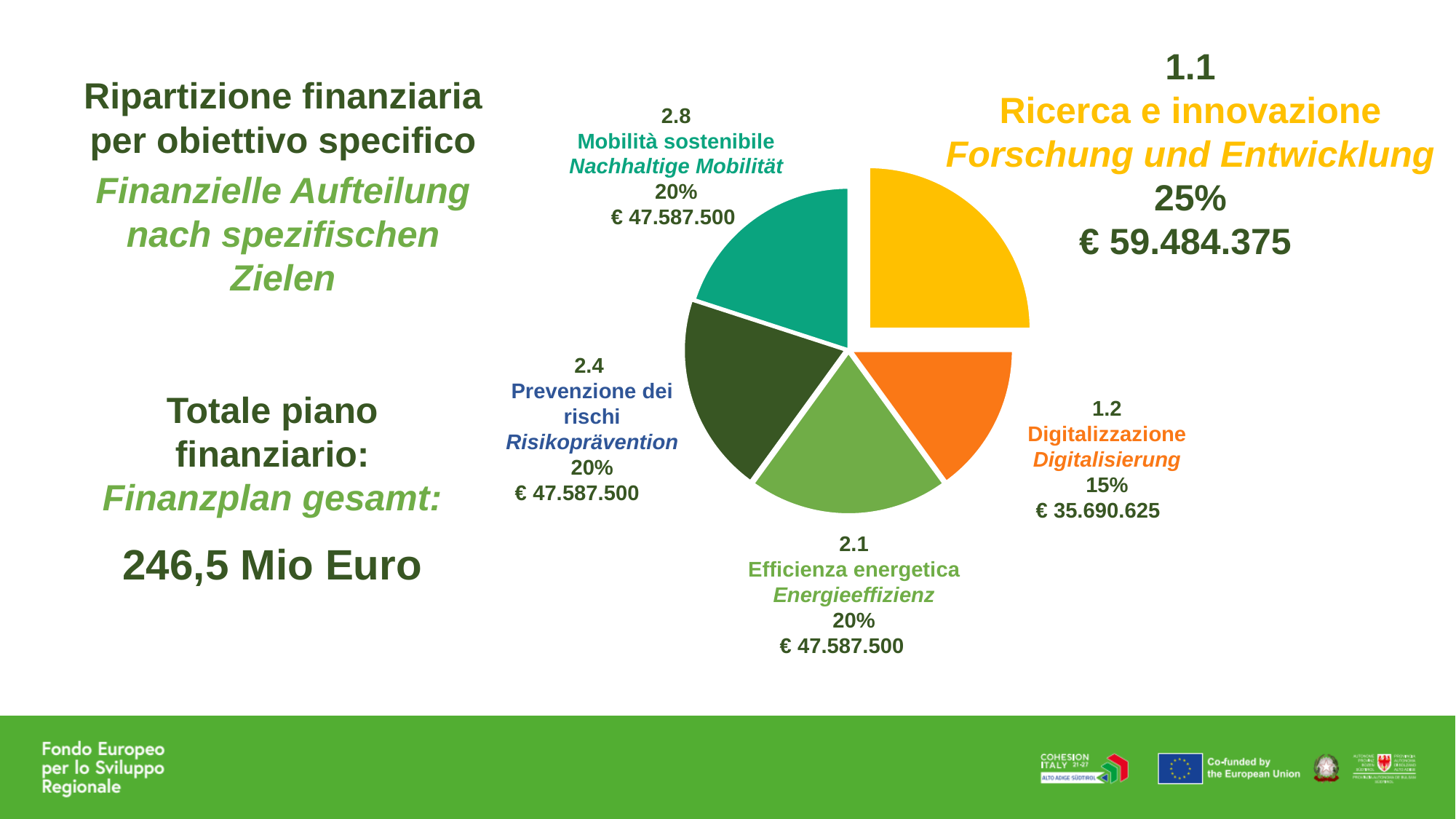
What colour is the slice for 1.2 Digitalizzazione? orange What kind of chart is shown on the slide? pie chart What is the amount shown for 2.8 Mobilità sostenibile? € 47.587.500 What is the total financial plan stated on the slide? 246,5 Mio Euro What percentage is shown for 2.4 Prevenzione dei rischi? 20% Which specific objective has the largest slice of the pie? 1.1 Ricerca e innovazione Which is larger, the amount for 2.1 Efficienza energetica or the amount for 1.2 Digitalizzazione? 2.1 Efficienza energetica How many slices does the pie chart have? 5 What share of the pie does 1.1 Ricerca e innovazione represent? 25% What is the difference in percentage between 1.1 Ricerca e innovazione and 1.2 Digitalizzazione? 10% Which specific objective has the smallest slice of the pie? 1.2 Digitalizzazione What is the amount shown for 1.2 Digitalizzazione? € 35.690.625